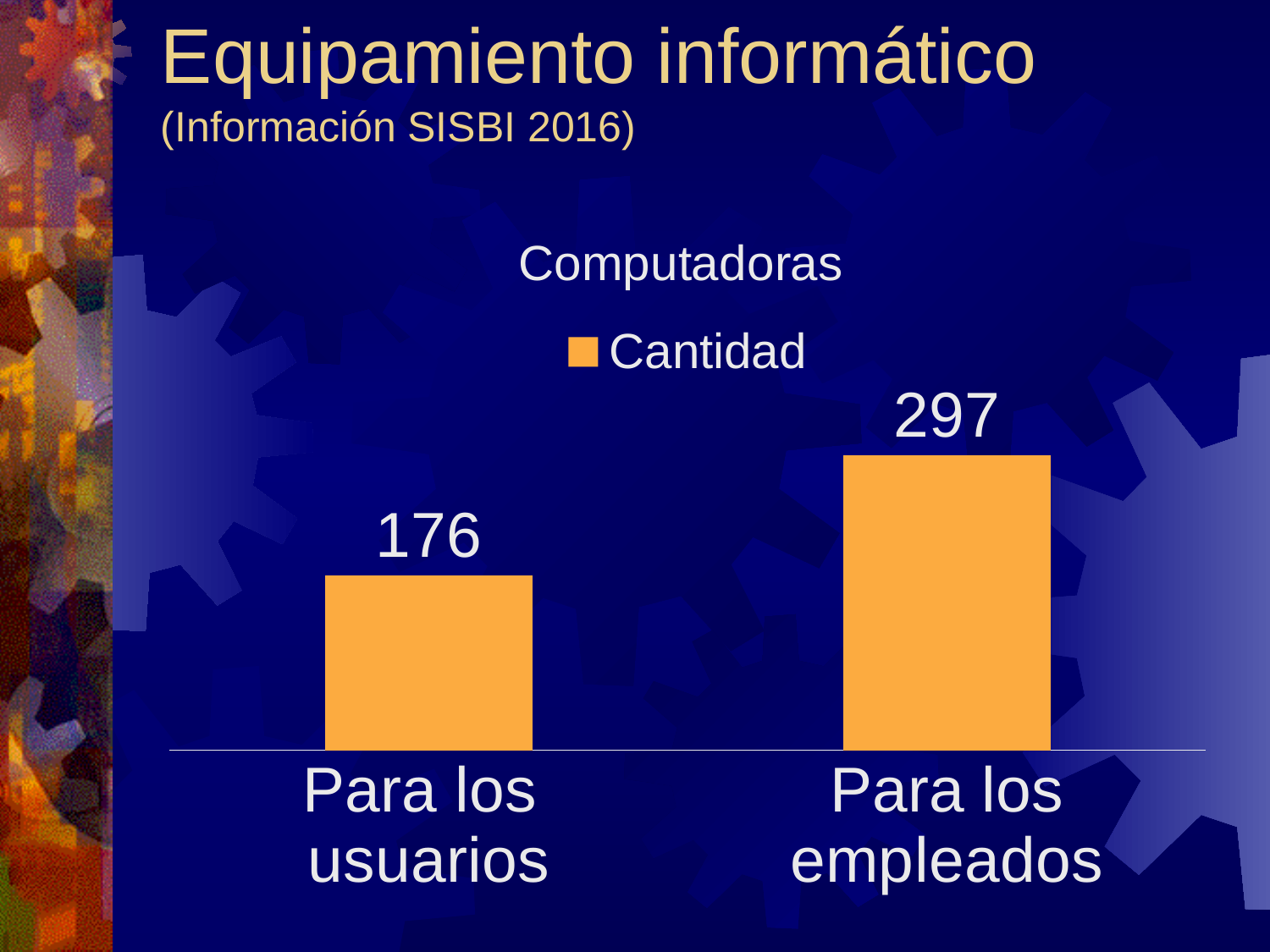
Which category has the highest value? Para los empleados How many categories are shown in the chart? 2 Which is larger, the value for "Para los usuarios" or the value for "Para los empleados"? Para los empleados What is the difference between the values for "Para los empleados" and "Para los usuarios"? 121 What is the title of the chart? Computadoras How many series does the legend list? 1 What kind of chart is shown on the slide? Bar chart What series name is shown in the chart legend? Cantidad Which category has the lowest value? Para los usuarios What is the value for "Para los usuarios"? 176 What is the value for "Para los empleados"? 297 What is the total of the two bars in the chart? 473